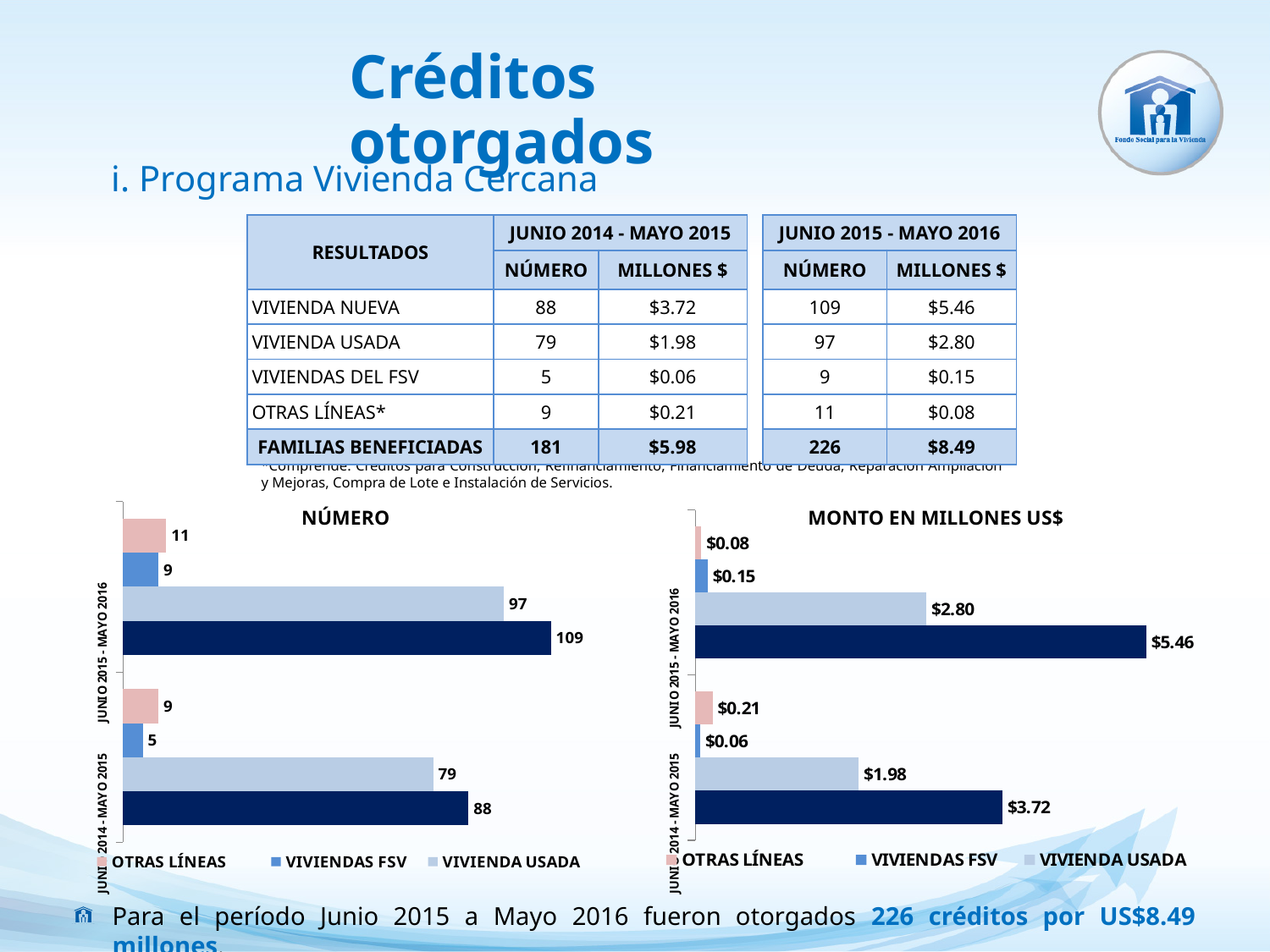
In the NÚMERO chart, what is the value for VIVIENDAS FSV in JUNIO 2015 - MAYO 2016? 9 In the NÚMERO chart, does the value for VIVIENDA USADA rise or fall from JUNIO 2014 - MAYO 2015 to JUNIO 2015 - MAYO 2016? Rise How many period groups are shown on the axis of the MONTO EN MILLONES US$ chart? 2 In the NÚMERO chart, what is the value for VIVIENDA USADA in JUNIO 2015 - MAYO 2016? 97 In the MONTO EN MILLONES US$ chart, what is the difference between VIVIENDAS FSV in JUNIO 2015 - MAYO 2016 and in JUNIO 2014 - MAYO 2015? $0.09 In the MONTO EN MILLONES US$ chart, which period has the larger value for OTRAS LÍNEAS? JUNIO 2014 - MAYO 2015 What kind of chart is the NÚMERO chart? Bar chart In the MONTO EN MILLONES US$ chart, what is the value for VIVIENDA USADA in JUNIO 2014 - MAYO 2015? $1.98 In the MONTO EN MILLONES US$ chart, what is the largest value shown on any bar? $5.46 In the NÚMERO chart, how much higher is VIVIENDA USADA in JUNIO 2015 - MAYO 2016 than in JUNIO 2014 - MAYO 2015? 18 In the NÚMERO chart for JUNIO 2015 - MAYO 2016, which is larger: OTRAS LÍNEAS or VIVIENDAS FSV? OTRAS LÍNEAS In the NÚMERO chart, what is the smallest value shown on any bar? 5